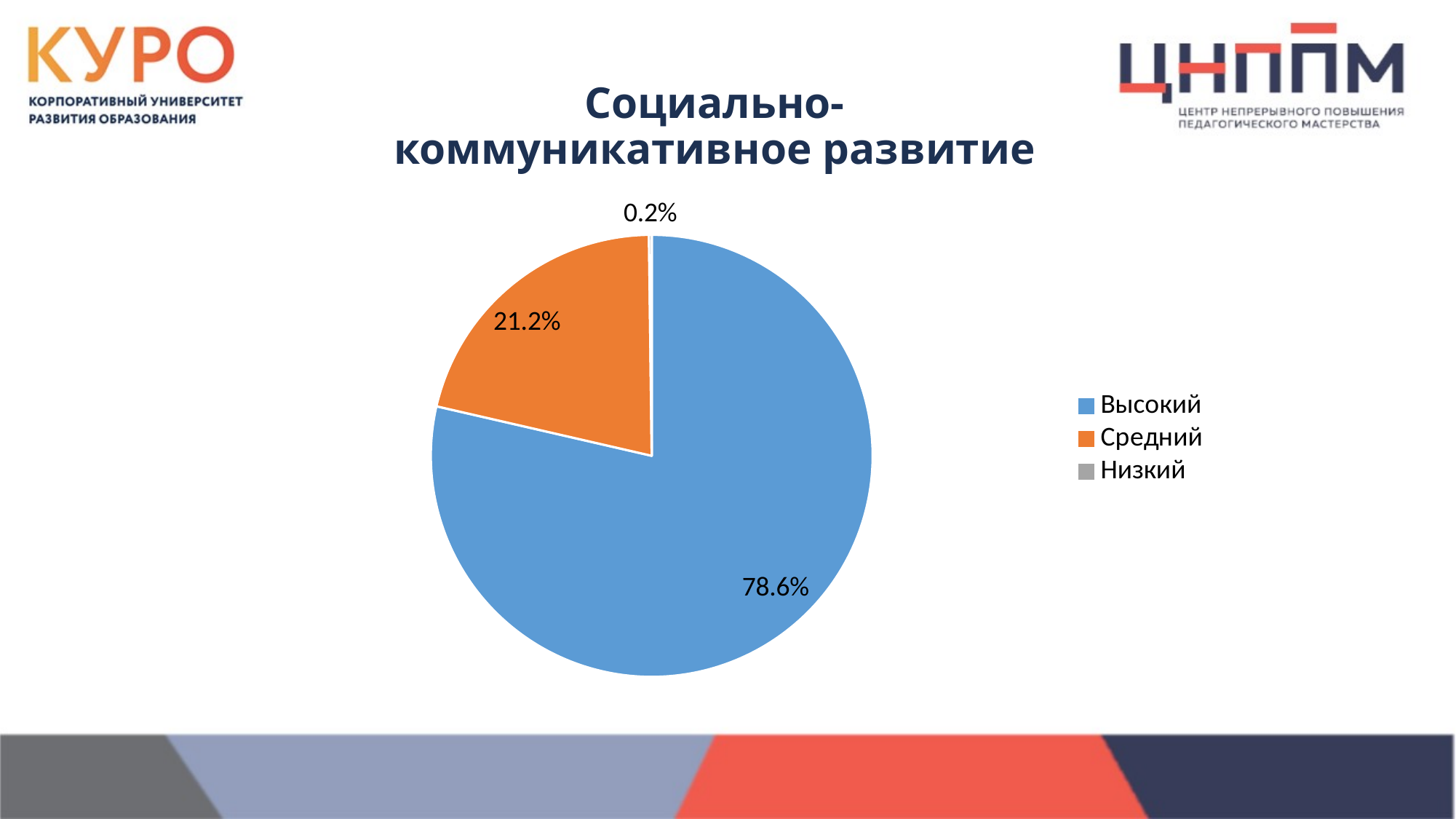
What colour is the slice for Средний? orange Which category has the largest share of the pie? Высокий What is the difference in percentage points between Высокий and Средний? 57.4 Is the share for Высокий greater or less than 50%? greater What is the share for Низкий? 0.2% What is the share for Высокий? 78.6% How many categories does the legend list? 3 What is the title of the chart? Социально-коммуникативное развитие What kind of chart is shown on the slide? pie chart What is the share for Средний? 21.2% Which category has the smallest share of the pie? Низкий Which is larger, the share for Средний or the share for Низкий? Средний